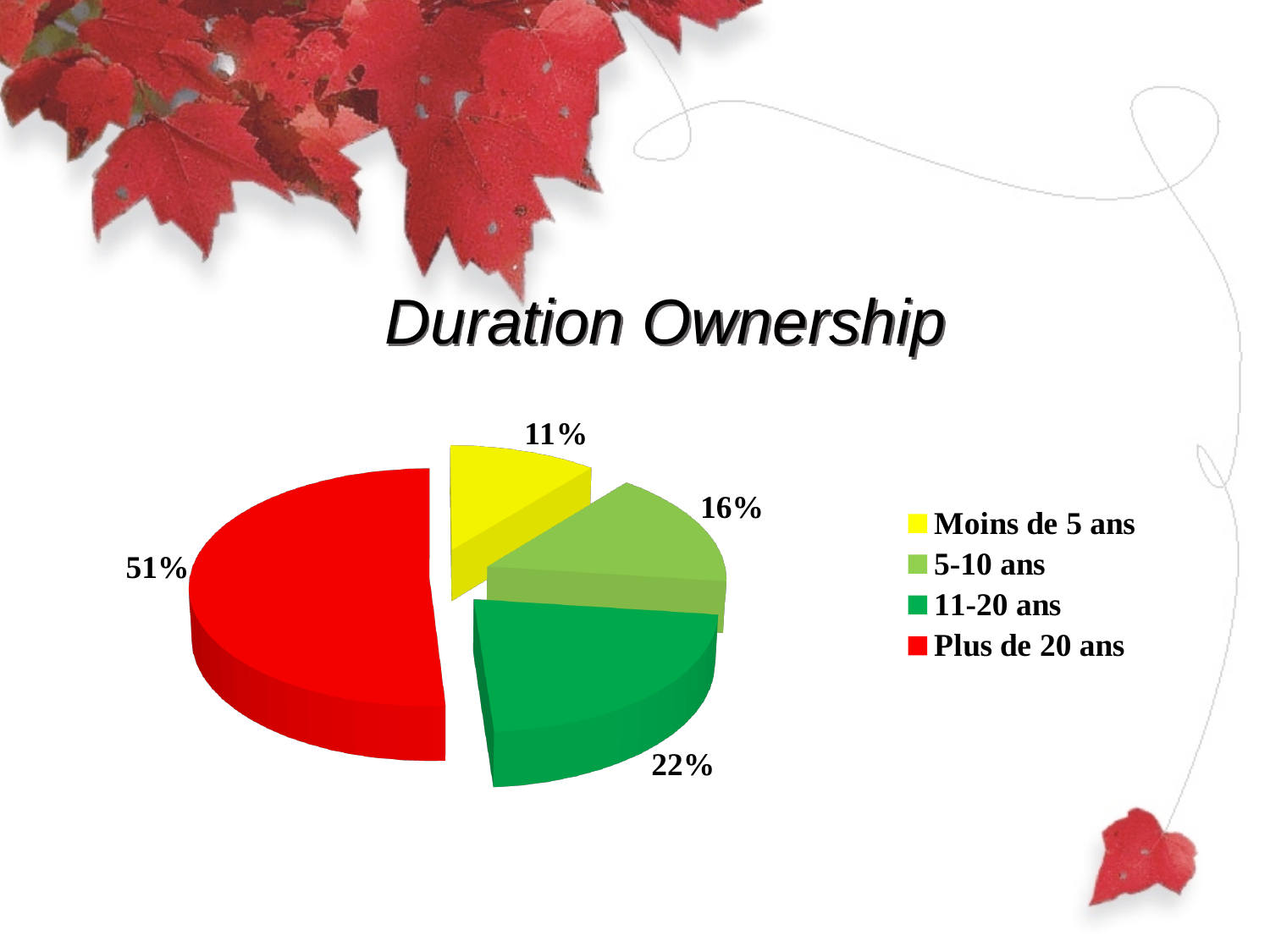
What is the difference in percentage points between 'Plus de 20 ans' and '11-20 ans'? 29 How many categories does the pie chart have? 4 Which category has the largest slice of the pie? Plus de 20 ans What share of the pie is 'Moins de 5 ans'? 11% What is the title of the chart? Duration Ownership What type of chart is shown on the slide? pie chart What share of the pie is '5-10 ans'? 16% What share of the pie is 'Plus de 20 ans'? 51% Which colour represents 'Plus de 20 ans' in the legend? red Which category has the smallest slice of the pie? Moins de 5 ans Which is larger, the share for '5-10 ans' or the share for '11-20 ans'? 11-20 ans